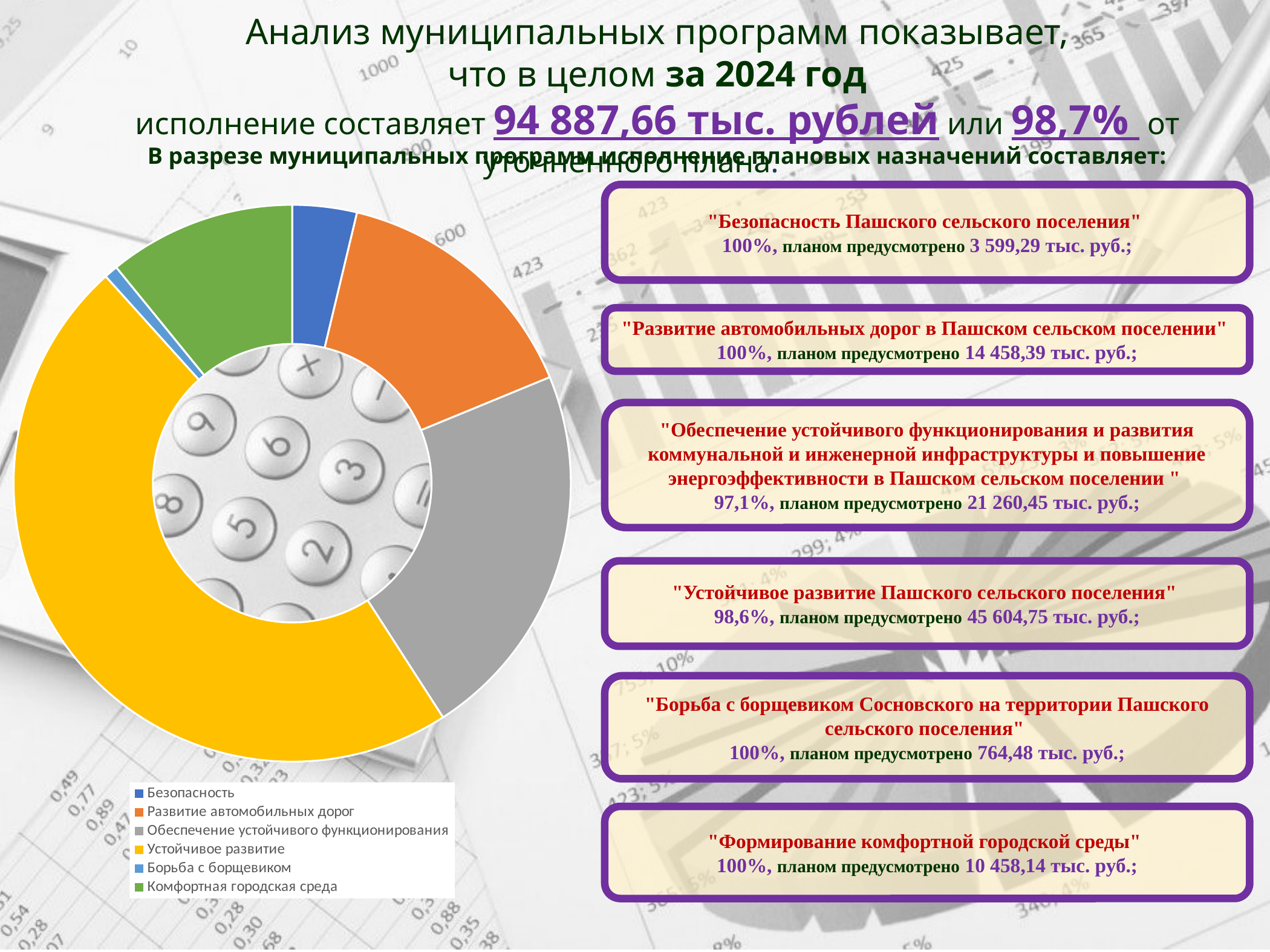
How many categories does the doughnut chart's legend list? 6 What colour is the Устойчивое развитие slice in the doughnut chart? Yellow Which slice is larger in the doughnut chart: Комфортная городская среда or Безопасность? Комфортная городская среда Which slice is larger in the doughnut chart: Развитие автомобильных дорог or Безопасность? Развитие автомобильных дорог Which slice is larger in the doughnut chart: Обеспечение устойчивого функционирования or Развитие автомобильных дорог? Обеспечение устойчивого функционирования Which category has the smallest slice in the doughnut chart? Борьба с борщевиком Which category has the largest slice in the doughnut chart? Устойчивое развитие What kind of chart is shown on the slide? Doughnut (pie) chart Which category is shown in blue in the doughnut chart's legend, listed first? Безопасность